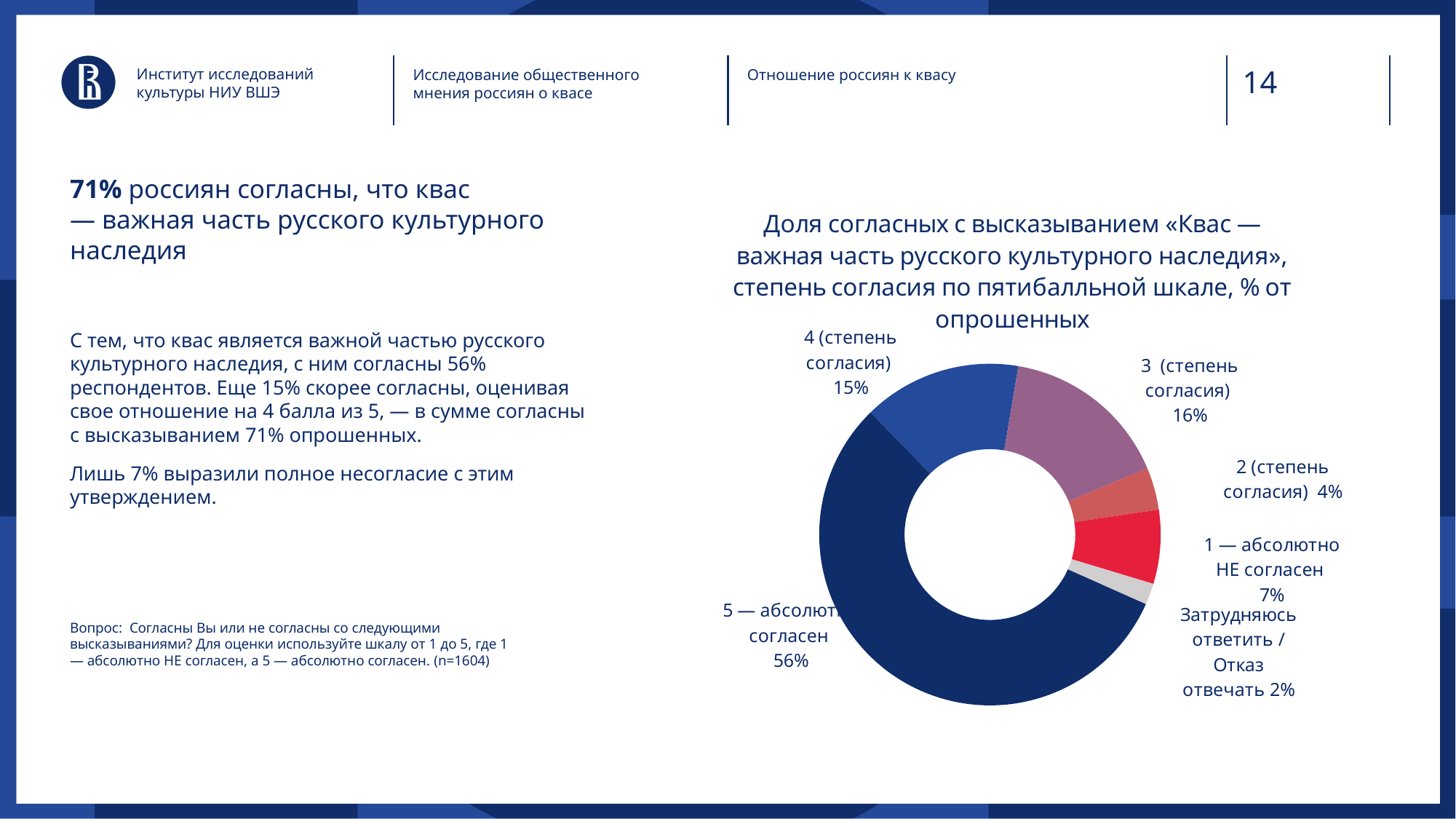
What share of respondents answered "Затрудняюсь ответить / Отказ отвечать"? 2% What type of chart is shown on the slide? Donut (pie) chart What is the combined share of "5 — абсолютно согласен" and "4 (степень согласия)"? 71% How many categories are shown in the chart? 6 What share of respondents chose "5 — абсолютно согласен"? 56% Which category has the largest share in the chart? 5 — абсолютно согласен What share of respondents chose "4 (степень согласия)"? 15% What share of respondents chose "3 (степень согласия)"? 16% What share of respondents chose "1 — абсолютно НЕ согласен"? 7% What is the difference in percentage points between "5 — абсолютно согласен" and "4 (степень согласия)"? 41 Which category has the smallest share in the chart? Затрудняюсь ответить / Отказ отвечать Which is larger: the share for "3 (степень согласия)" or for "2 (степень согласия)"? 3 (степень согласия)